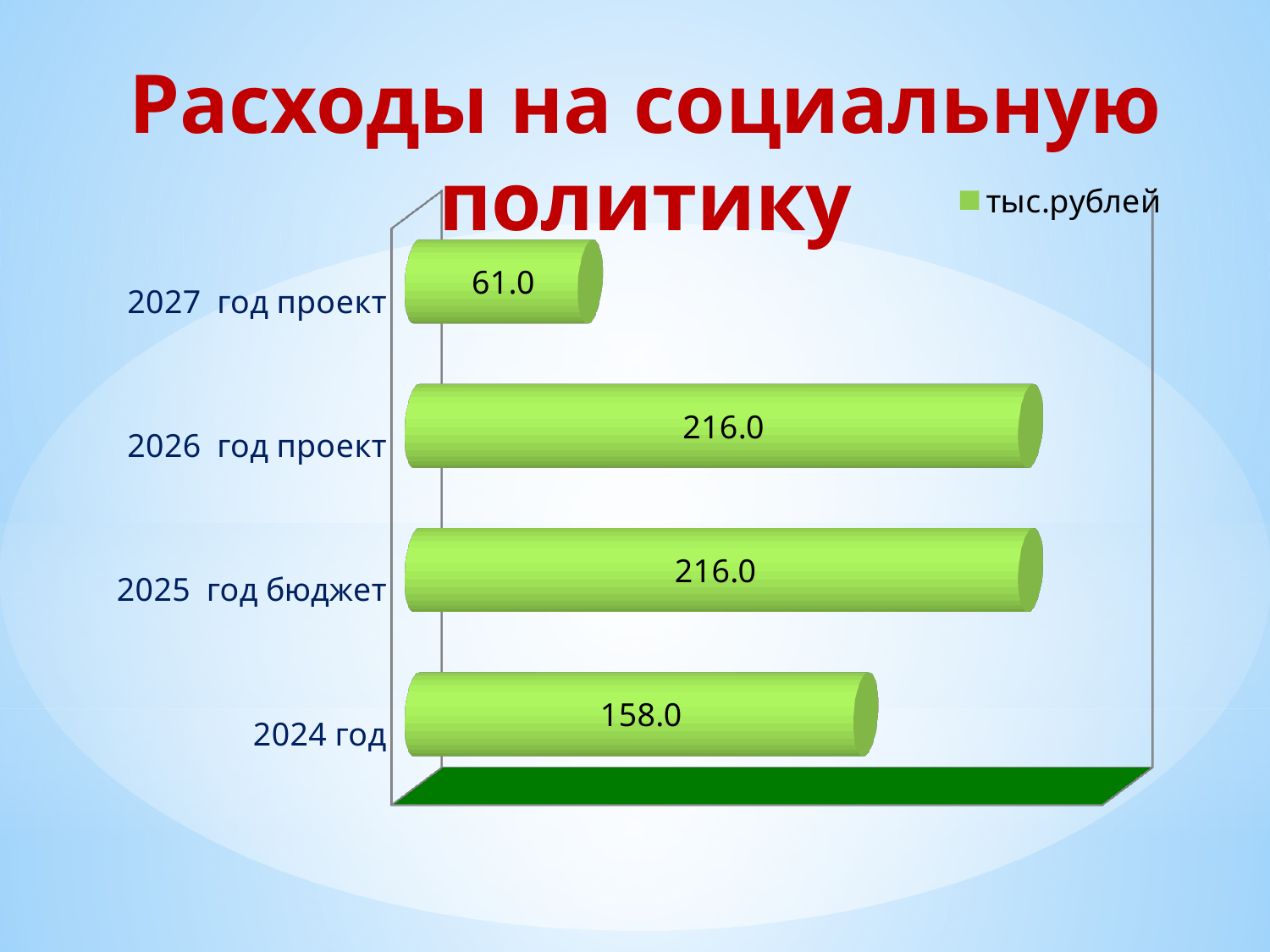
Which is larger, the value for 2024 год or the value for 2027 год проект? 2024 год What is the title of the chart? Расходы на социальную политику What is the value for 2024 год? 158.0 What is the value for 2025 год бюджет? 216.0 What kind of chart is shown on the slide? bar chart How many categories are shown in the chart? 4 What is the difference between the values for 2025 год бюджет and 2024 год? 58.0 What is the difference between the values for 2024 год and 2027 год проект? 97.0 What is the value for 2027 год проект? 61.0 What is the value for 2026 год проект? 216.0 Which category has the lowest value? 2027 год проект How many series does the legend list? 1